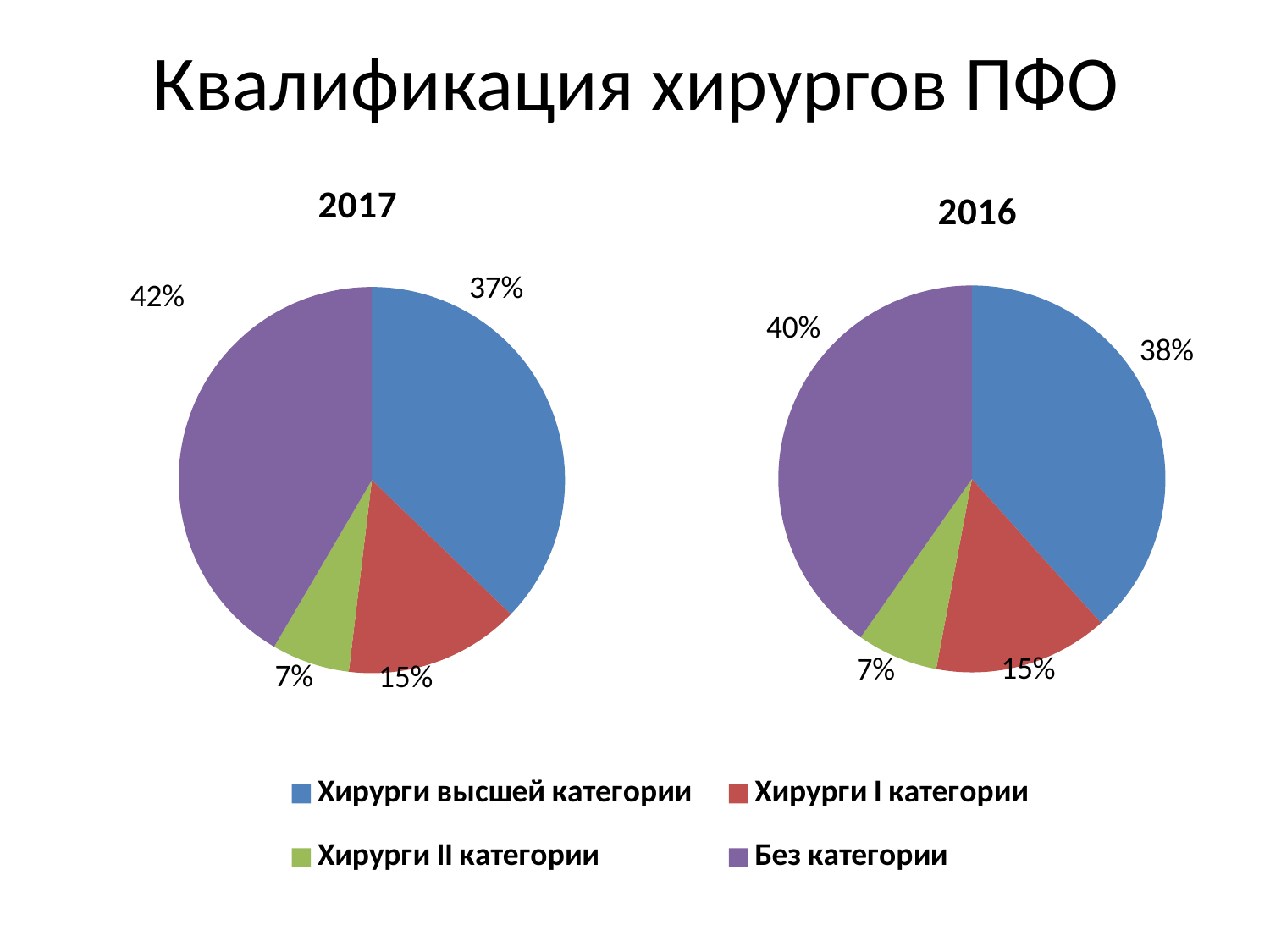
In the 2017 pie chart, what share do surgeons of category I (Хирурги I категории) have? 15% In the 2017 pie chart, which category has the largest share? Без категории How many slices does the 2016 pie chart have? 4 In the 2016 pie chart, what share do surgeons of the highest category (Хирурги высшей категории) have? 38% In the 2016 pie chart, what share do surgeons of category II (Хирурги II категории) have? 7% Which is larger: the share of surgeons without a category in 2017 or in 2016? 2017 In the 2016 pie chart, which category has the smallest share? Хирурги II категории In the 2017 pie chart, what share do surgeons without a category (Без категории) have? 42% In the 2017 pie chart, what is the difference between the share of surgeons without a category and the share of surgeons of the highest category? 5% What colour represents surgeons of category I (Хирурги I категории) in the charts? Red How many entries does the legend list? 4 What type of chart is used on this slide? Pie chart